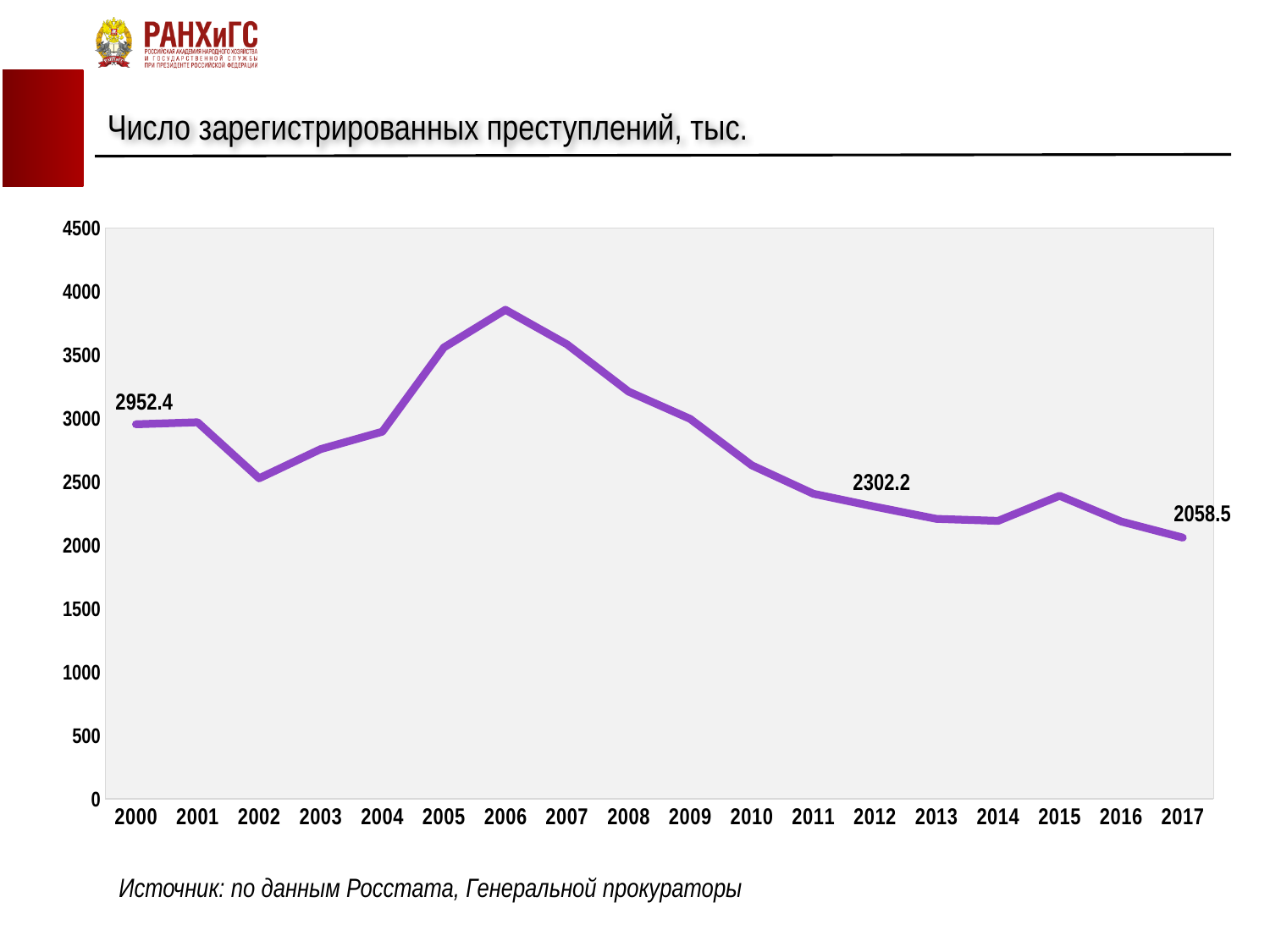
What is the value for 2000? 2952.4 What is the title of the chart? Число зарегистрированных преступлений, тыс. What is the difference between the values for 2012 and 2017? 243.7 Is the value for 2006 greater or less than 3500? greater Which year has the lowest value? 2017 Which is larger, the value for 2000 or the value for 2012? 2000 How many years are plotted on the x axis? 18 What is the value for 2012? 2302.2 What is the value for 2017? 2058.5 Which year has the highest value? 2006 What is the difference between the values for 2000 and 2017? 893.9 What type of chart is shown on the slide? line chart